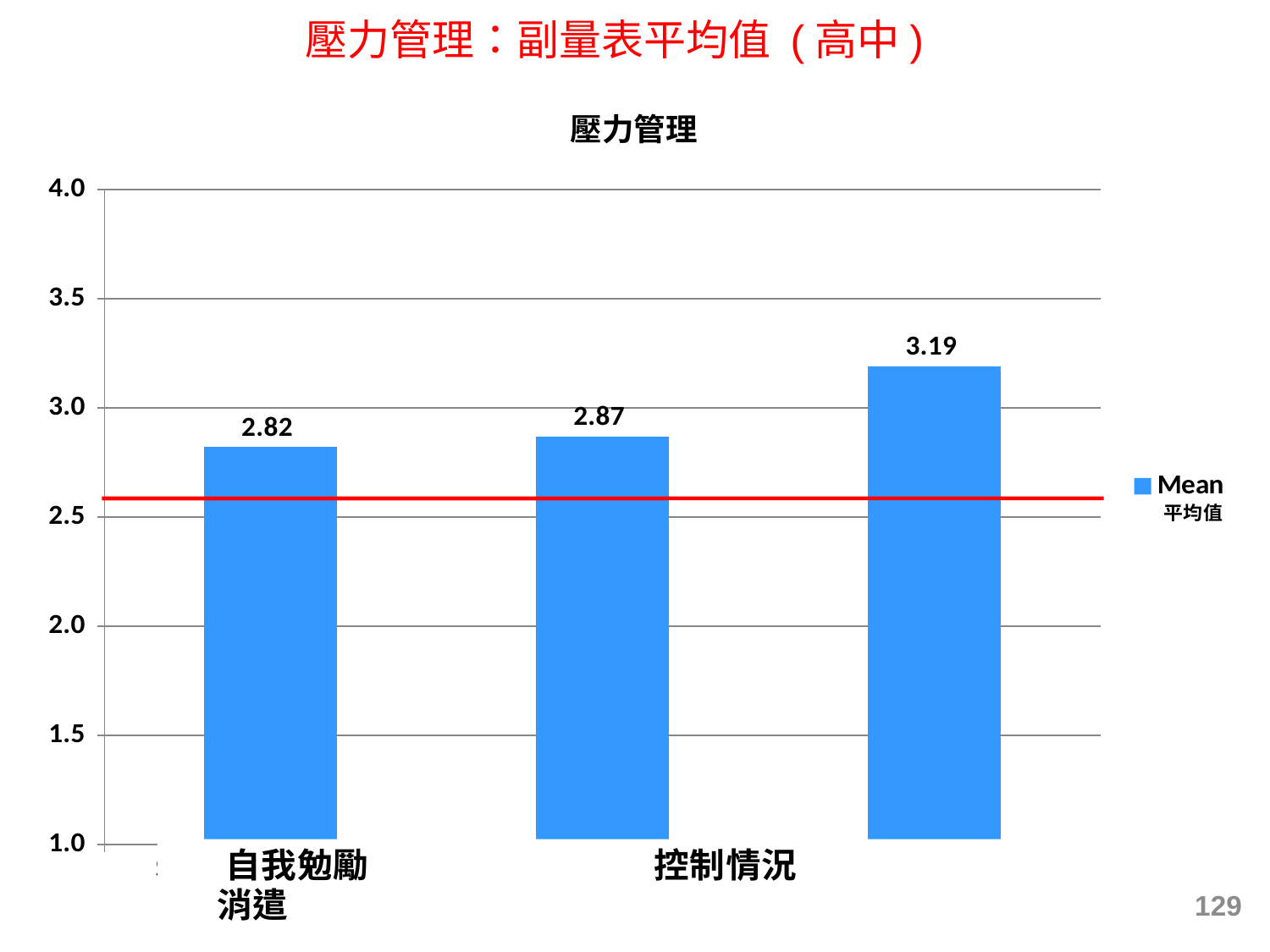
What is the difference between the values for 控制情況 and 自我勉勵? 0.05 What is the difference between the rightmost bar (3.19) and the bar for 自我勉勵? 0.37 Which labelled category has the lowest value? 自我勉勵 Is the value for 自我勉勵 greater or less than 3.0? less How many series does the legend list? 1 Which bar has the highest value? The rightmost bar (3.19) What is the value of the bar labelled 控制情況? 2.87 Which is larger, the value for 控制情況 or the value for 自我勉勵? 控制情況 What is the value of the bar labelled 自我勉勵? 2.82 What is the value of the rightmost bar in the chart? 3.19 What type of chart is shown on the slide? Bar chart How many bars are plotted in the chart? 3